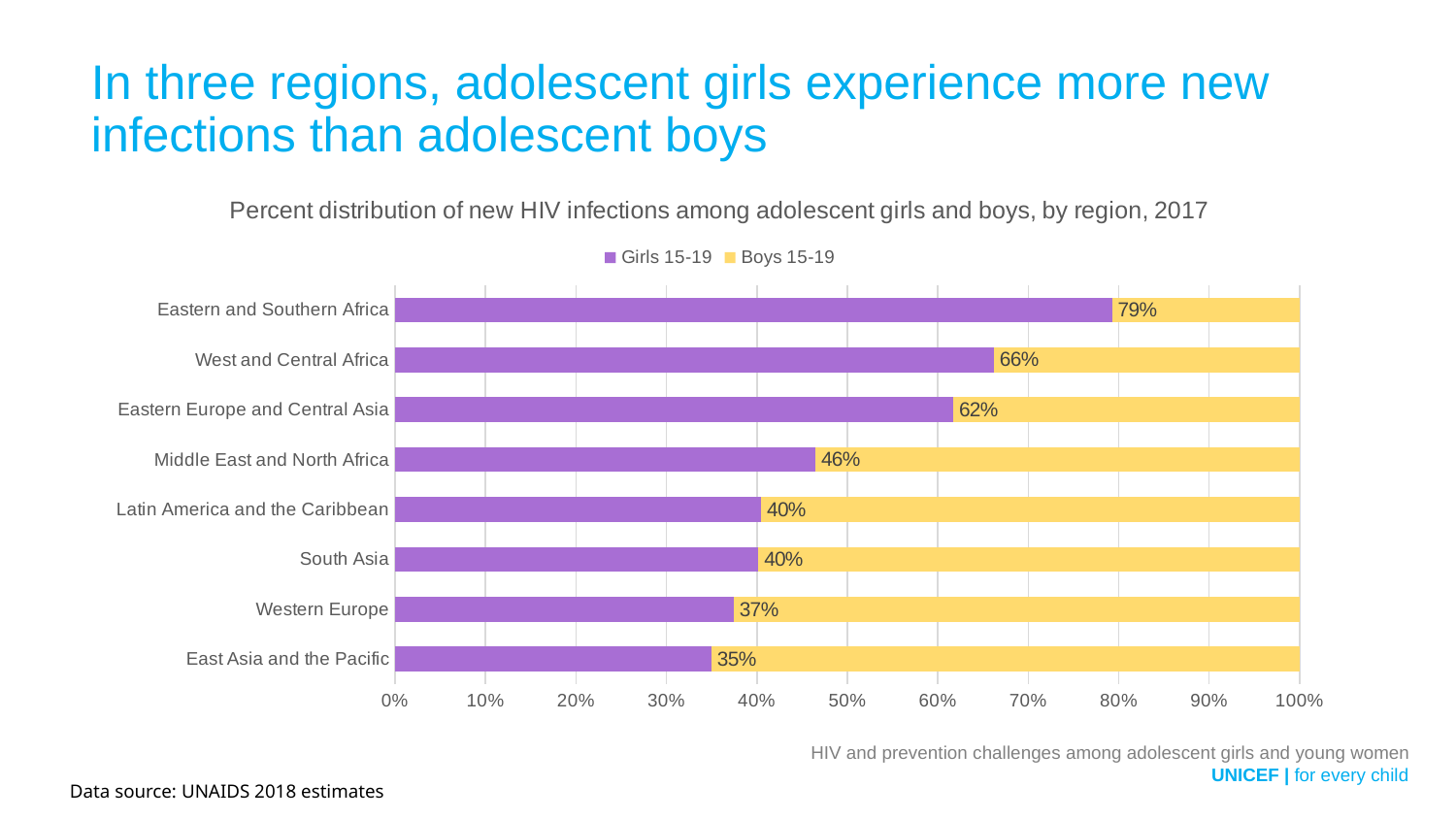
What is the value for Girls 15-19 in East Asia and the Pacific? 35% Which region has the highest value for Girls 15-19? Eastern and Southern Africa What is the value for Girls 15-19 in Eastern and Southern Africa? 79% Which region has the lowest value for Girls 15-19? East Asia and the Pacific How many series does the legend list? 2 What is the difference between the Girls 15-19 values for West and Central Africa and Eastern Europe and Central Asia? 4% What is the value for Girls 15-19 in Middle East and North Africa? 46% What kind of chart is shown on the slide? Stacked bar chart Is the Boys 15-19 value for Eastern and Southern Africa greater or less than 30%? less Which is larger, the Girls 15-19 value for Western Europe or for Middle East and North Africa? Middle East and North Africa What colour represents Boys 15-19 in the chart? Yellow How many regions are shown in the chart? 8